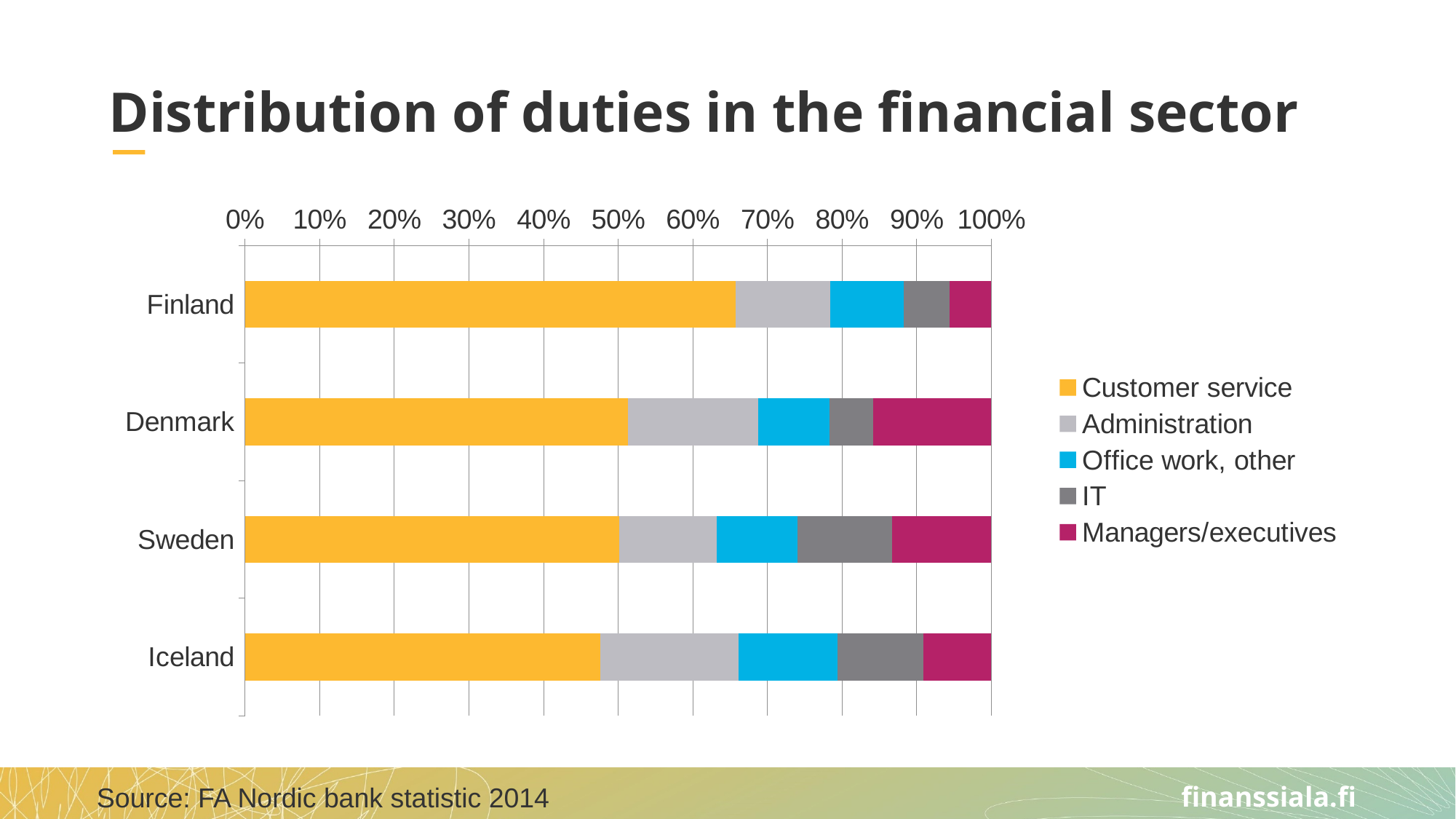
How many countries are shown on the chart? 4 Which series is listed first in the legend? Customer service What is the title of the chart on the slide? Distribution of duties in the financial sector Is the Customer service share for Iceland greater or less than 60%? less Which has a larger Customer service share, Finland or Iceland? Finland Which has a larger IT share, Sweden or Finland? Sweden Which country has the largest share of Customer service? Finland Which country has the smallest share of Managers/executives? Finland Which country has the largest share of Managers/executives? Denmark How many series does the legend list? 5 What kind of chart is shown on the slide? Stacked bar chart Is the Customer service share for Finland greater or less than 60%? greater